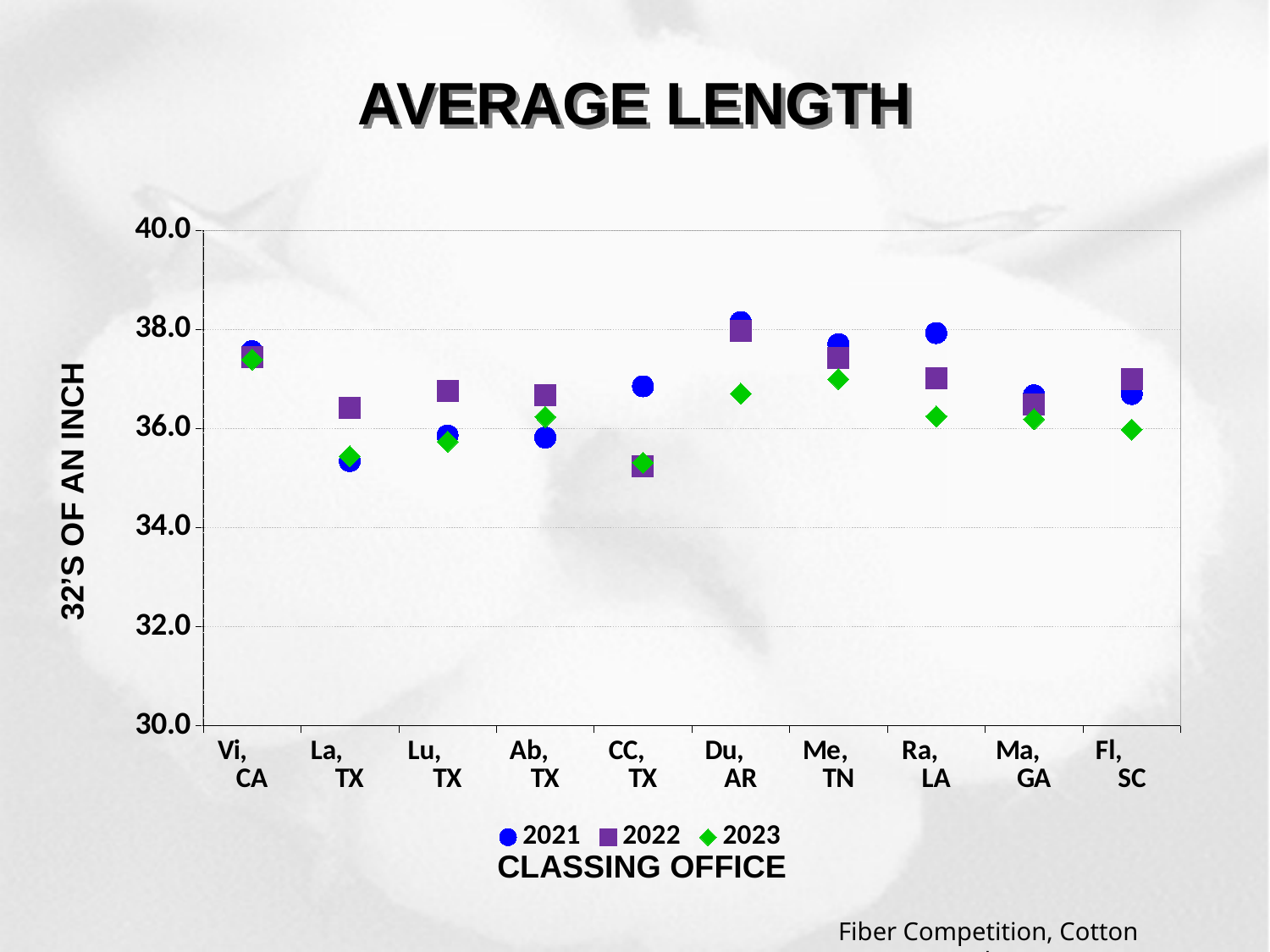
What is the title of the y axis? 32'S OF AN INCH Which classing office has the lowest 2022 value? CC, TX At CC, TX, which is larger: the 2021 value or the 2022 value? 2021 How many classing offices are shown on the x axis? 10 Is the 2021 value for Ra, LA greater or less than 36.0? greater Is the 2023 value for CC, TX greater or less than 36.0? less What kind of chart is shown on the slide? Scatter chart Which classing office has the highest 2022 value? Du, AR Which classing office has the highest 2021 value? Du, AR Which classing office has the lowest 2021 value? La, TX How many series does the legend list? 3 Which classing office has the highest 2023 value? Vi, CA